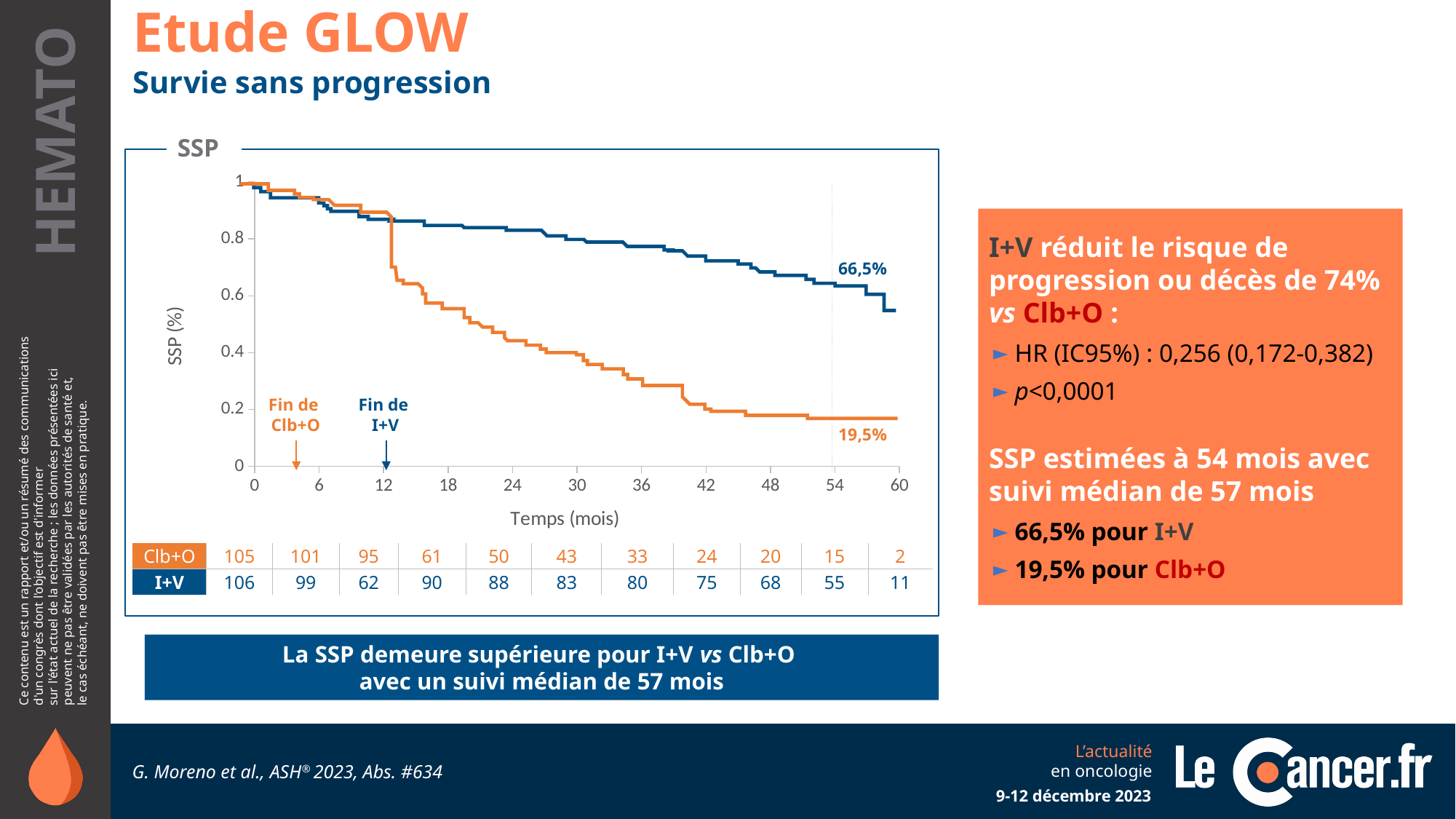
In the number-at-risk table, how many Clb+O patients are at risk at 0 months? 105 In the number-at-risk table, how many I+V patients are at risk at 24 months? 88 Do the SSP curves rise or fall as time (months) increases? fall Is the SSP value for Clb+O at 36 months greater or less than 0.4? less What is the label of the x axis of the SSP chart? Temps (mois) What is the SSP value labelled for I+V at 54 months? 66,5% How many series (treatment arms) are plotted on the SSP chart? 2 What is the difference between the labelled SSP values for I+V and Clb+O at 54 months? 47 points What kind of chart is shown on the slide? line chart What is the SSP value labelled for Clb+O at 54 months? 19,5% Is the SSP value for I+V at 36 months greater or less than 0.6? greater Which arm has the higher SSP curve at 54 months, I+V or Clb+O? I+V